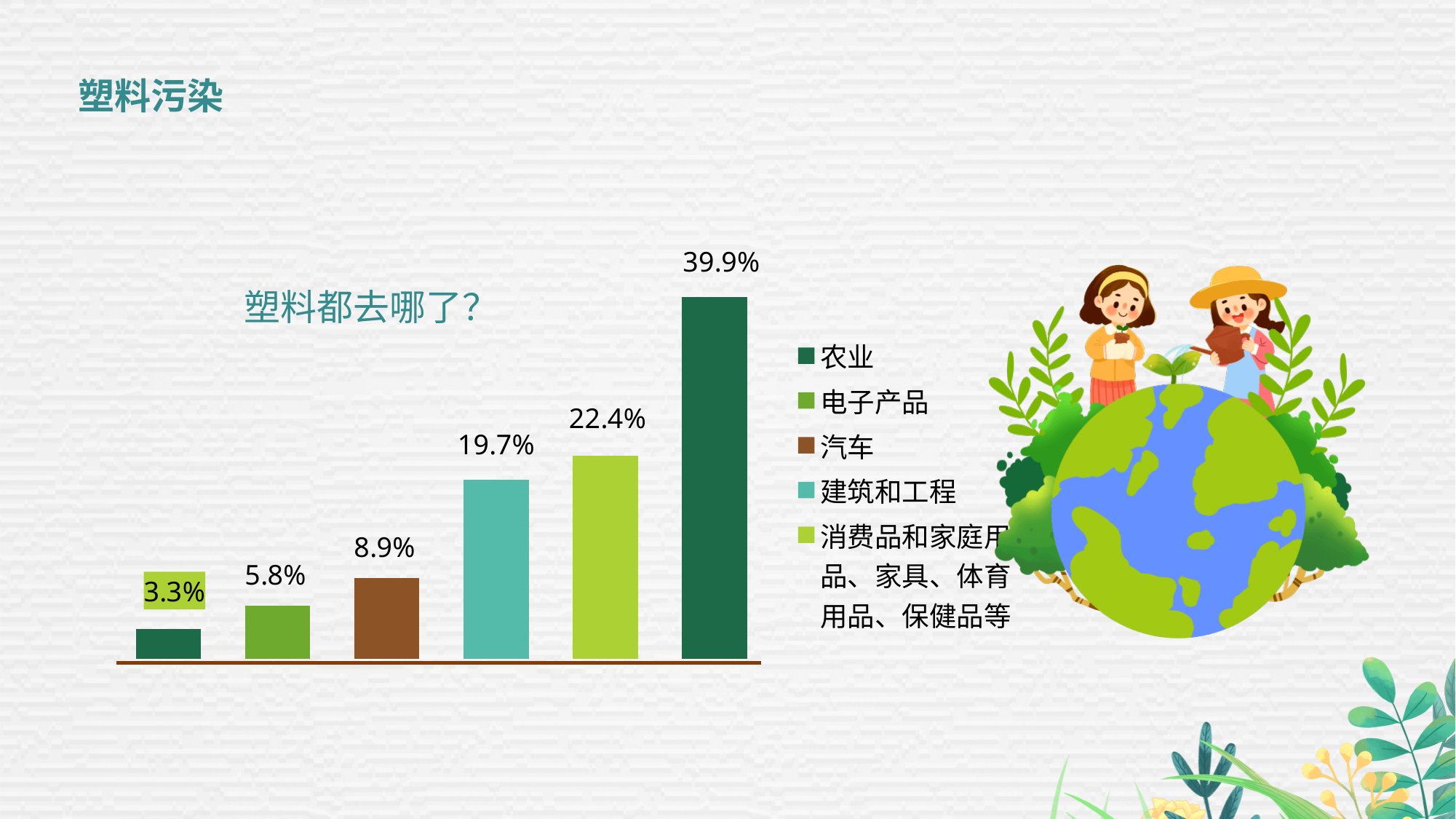
What is the highest value shown on the chart? 39.9% How many entries does the legend list? 5 Which is larger, the value for 消费品和家庭用品、家具、体育用品、保健品等 or the value for 建筑和工程? 消费品和家庭用品、家具、体育用品、保健品等 What kind of chart is shown on the slide? bar chart Do the bar values rise or fall from left to right? rise What is the lowest value shown on the chart? 3.3% What is the value for 消费品和家庭用品、家具、体育用品、保健品等 (the light green bar)? 22.4% How many bars are plotted on the chart? 6 What is the difference between the values for 建筑和工程 and 汽车? 10.8% What is the value for 电子产品 (the green bar)? 5.8% What is the value for 汽车 (the brown bar)? 8.9% What is the value for 建筑和工程 (the teal bar)? 19.7%